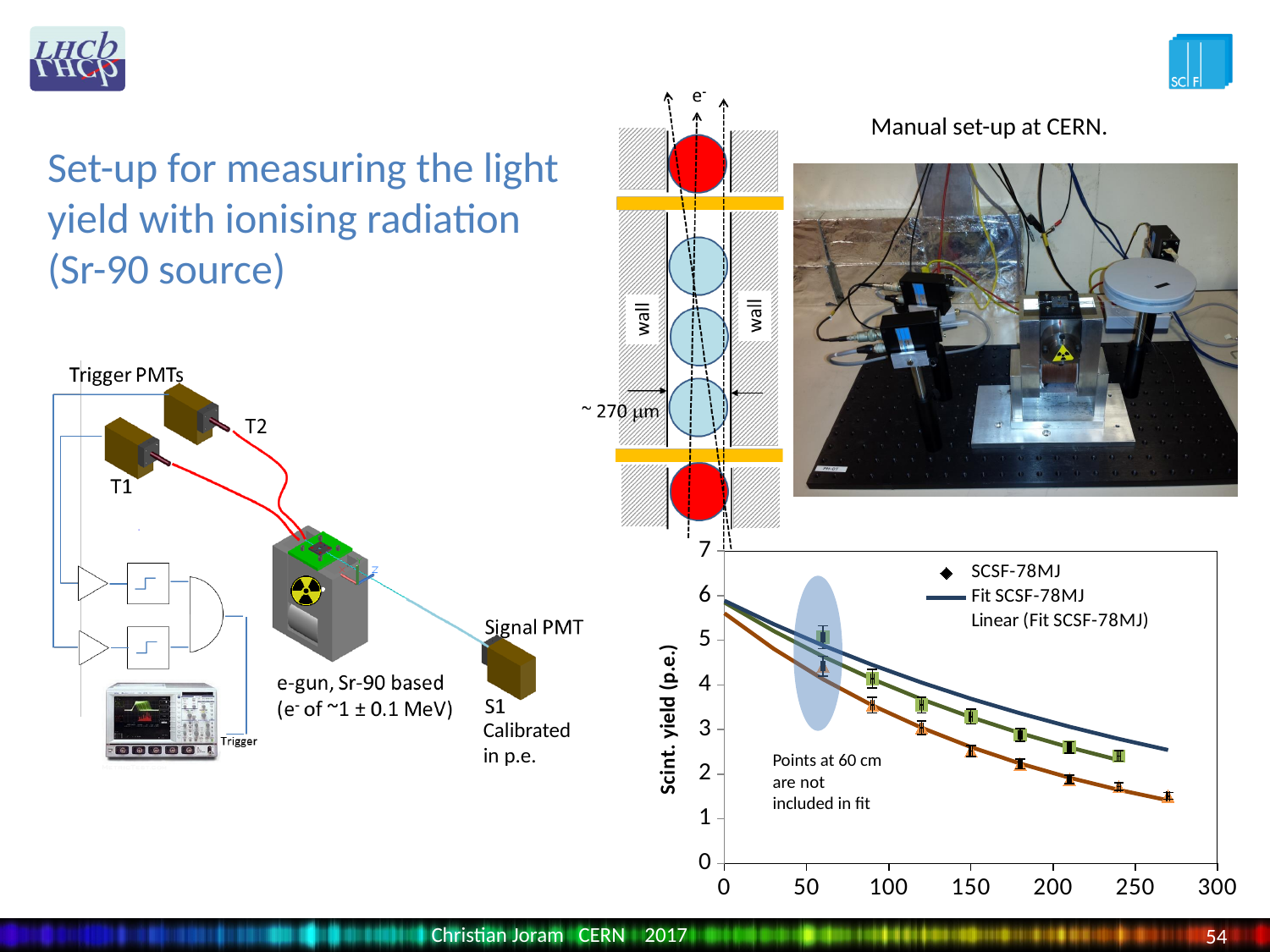
Is the highest plotted point at x = 60 greater or less than 4 on the y axis? greater Which is larger: the plotted value at x = 90 or the plotted value at x = 270? x = 90 Is the plotted point at x = 270 greater or less than 2 on the y axis? less Is the lowest plotted point at x = 150 greater or less than 3 on the y axis? less Do the plotted scintillation yield values rise or fall as the x-axis value increases? fall According to the annotation on the chart, points at which distance are not included in the fit? 60 cm What kind of chart is shown at the bottom right of the slide? scatter chart with fit lines What is the label of the vertical axis of the chart? Scint. yield (p.e.) What is the maximum value shown on the x axis of the chart? 300 How many entries does the legend of the chart list? 3